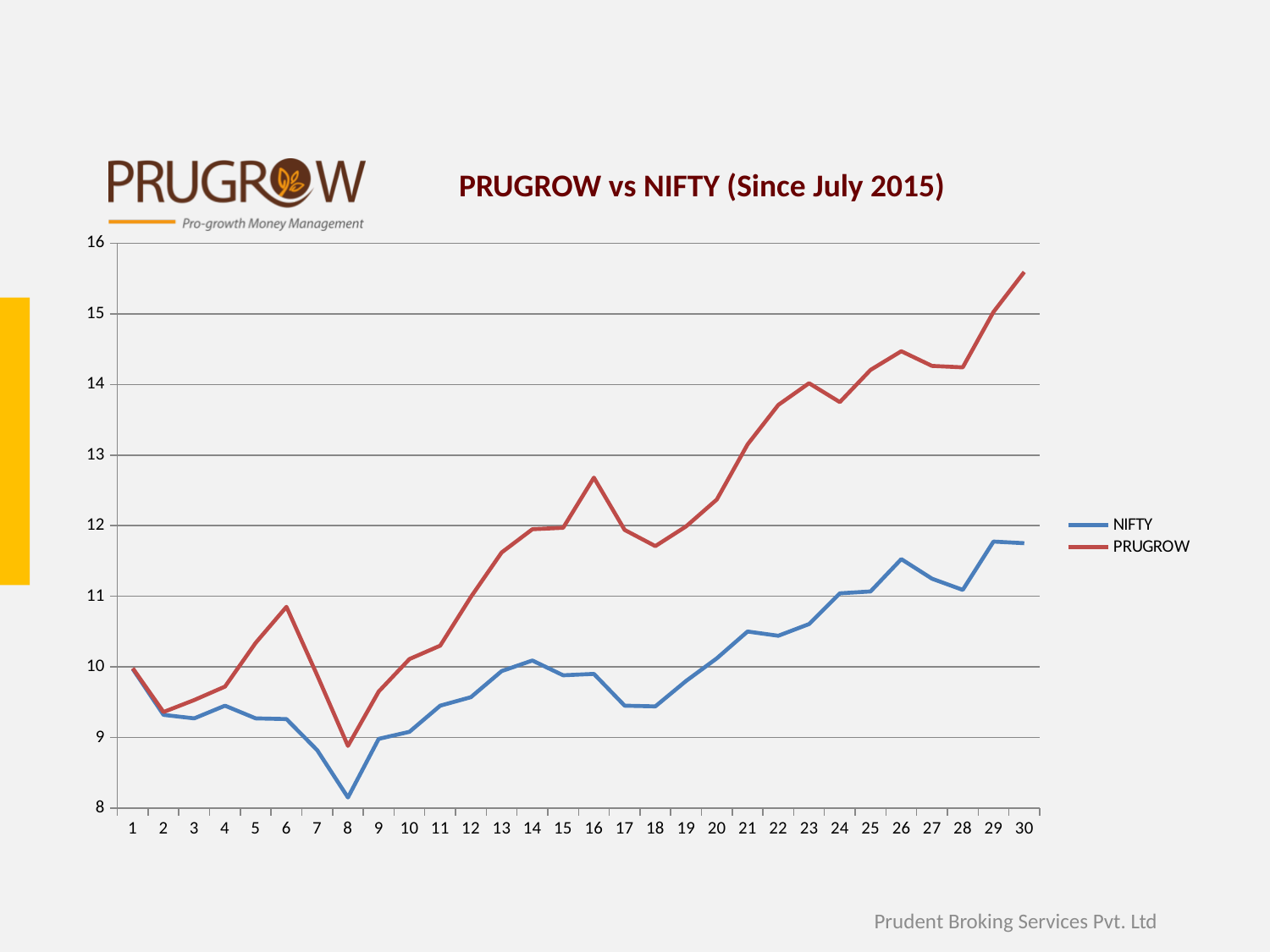
Is the value for NIFTY at point 8 greater or less than 9? less Is the value for PRUGROW at point 30 greater or less than 15? greater At point 30, which series has the higher value, NIFTY or PRUGROW? PRUGROW What is the title of the chart? PRUGROW vs NIFTY (Since July 2015) At which x-axis point does the PRUGROW series reach its highest value? 30 Overall, do the PRUGROW values rise or fall from point 1 to point 30? Rise How many series does the legend list? 2 At which x-axis point does the NIFTY series reach its lowest value? 8 At which x-axis point does the PRUGROW series reach its lowest value? 8 What kind of chart is shown on the slide? Line chart Which series is drawn in red? PRUGROW How many points are plotted along the x axis for each series? 30